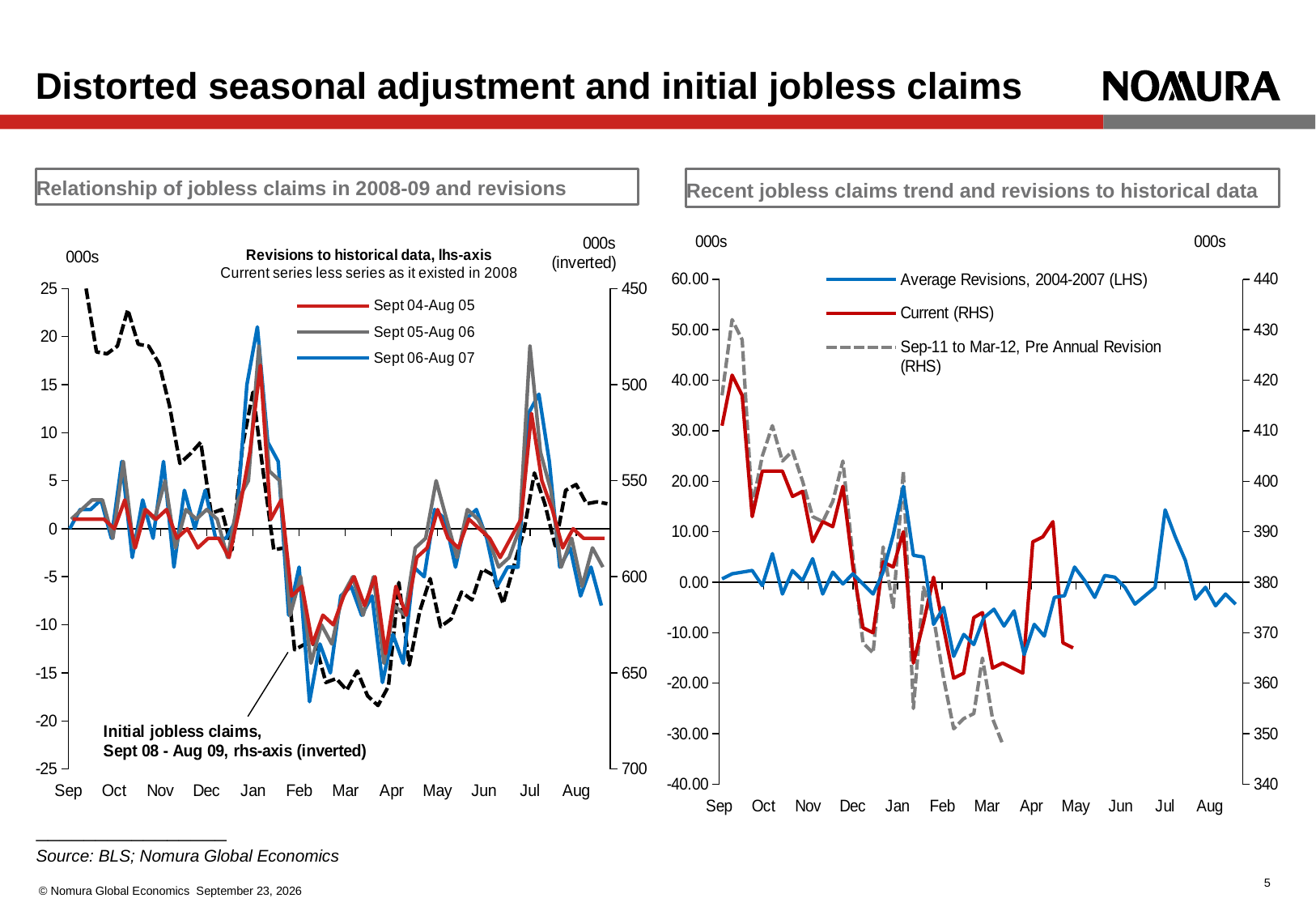
In the right chart, how many series does the legend list? 3 In the left chart, is the peak value of the 'Sept 06-Aug 07' series in January greater or less than 15? greater How many months are labelled on the x axis of the right chart? 12 What type of chart is the left chart, 'Relationship of jobless claims in 2008-09 and revisions'? line chart In the left chart, which series is shown in blue? Sept 06-Aug 07 In the left chart, is the lowest value of the 'Sept 06-Aug 07' series in February greater or less than -15? less In the right chart, does the 'Current (RHS)' series generally rise or fall from September to March? fall What type of chart is the right chart, 'Recent jobless claims trend and revisions to historical data'? line chart In the right chart, which series is plotted with a dashed grey line? Sep-11 to Mar-12, Pre Annual Revision (RHS) In the left chart, how many series does the legend list? 3 In the right chart, is the 'Current (RHS)' series value at the start of September greater or less than 400 on the right-hand axis? greater